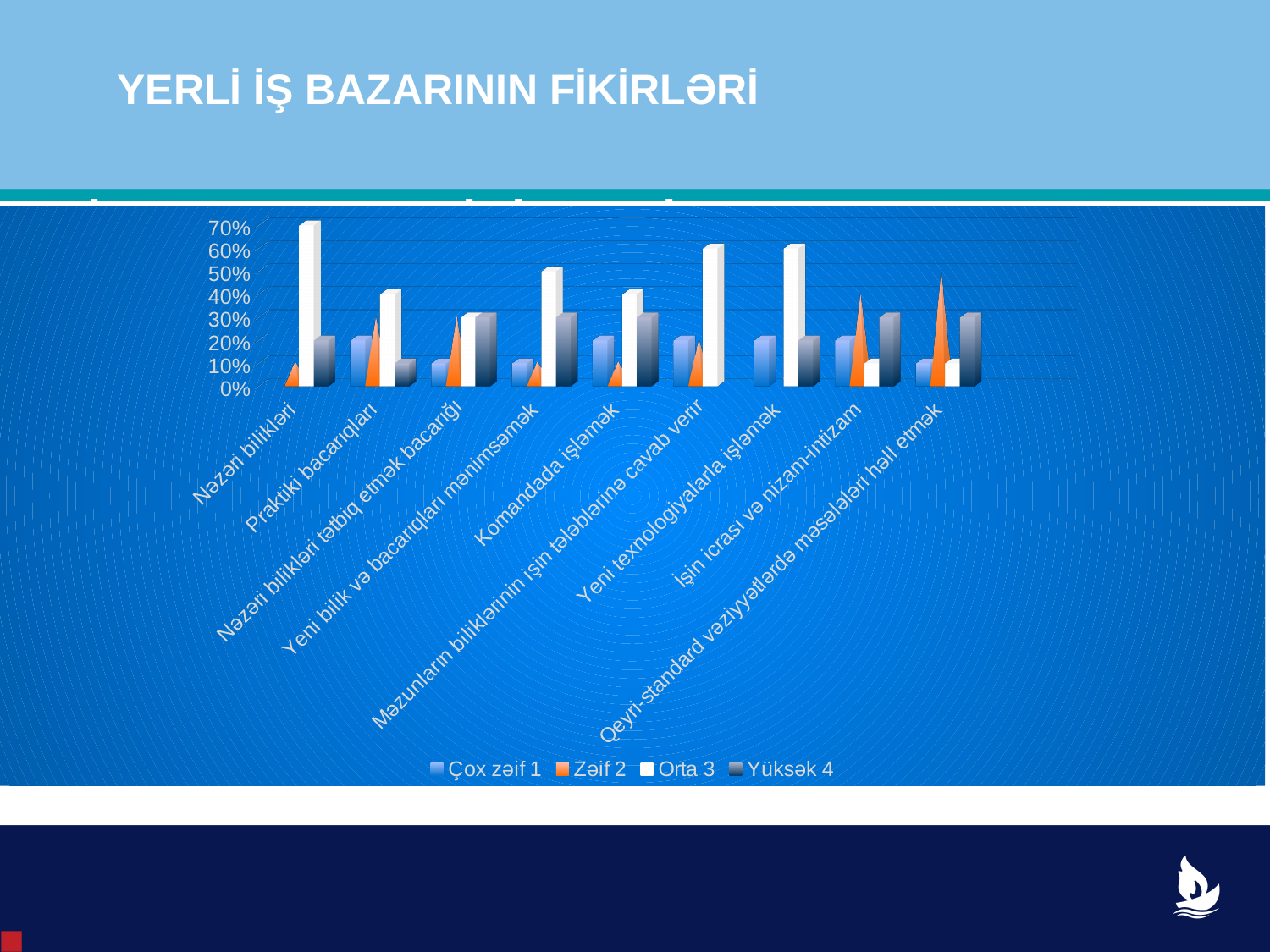
Is the Çox zəif 1 value for Praktiki bacarıqları greater or less than 30%? less Is the Orta 3 value for İşin icrası və nizam-intizam greater or less than 50%? less Is the Orta 3 value for Nəzəri bilikləri greater or less than 50%? greater What are the four series names listed in the chart legend? Çox zəif 1, Zəif 2, Orta 3, Yüksək 4 What is the title of the slide? YERLİ İŞ BAZARININ FİKİRLƏRİ Which category has the highest value for the Orta 3 series? Nəzəri bilikləri Which is larger: the Orta 3 value for Nəzəri bilikləri or the Orta 3 value for Praktiki bacarıqları? Nəzəri bilikləri How many categories are shown on the x axis of the chart? 9 How many series does the legend list? 4 What kind of chart is shown on the slide? bar chart